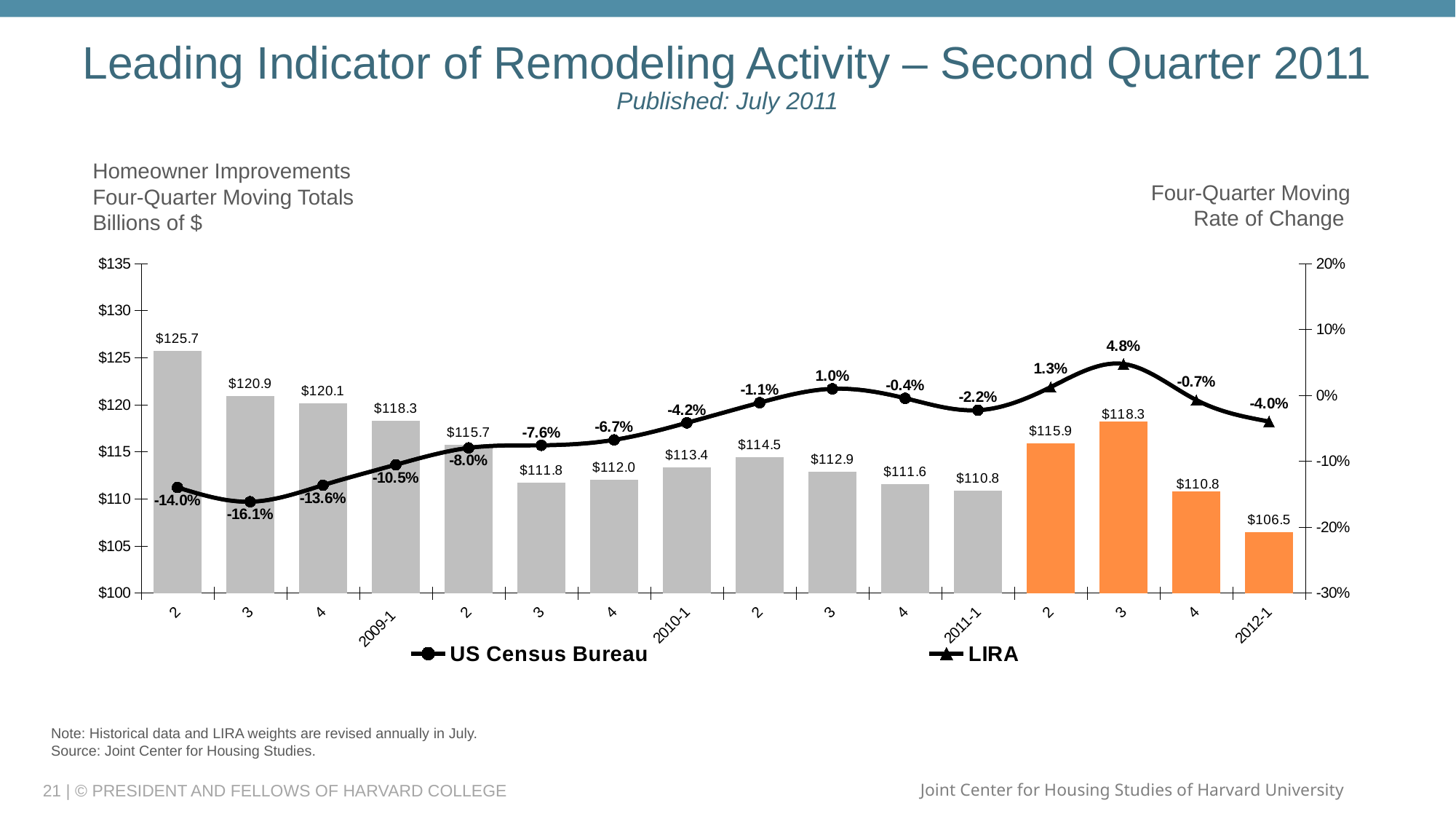
What is the lowest rate of change value plotted on the line? -16.1% What is the difference between the bar values for 2011-1 and 2012-1? $4.3 Which has the larger bar value, 2009-1 or 2010-1? 2009-1 Which category has the lowest bar value? 2012-1 What is the four-quarter moving rate of change shown for 2011-1? -2.2% What colour are the last four bars on the chart? Orange How many bars are plotted on the chart? 16 What is the highest bar value shown on the chart? $125.7 How many series does the legend list? 2 What is the value of the bar for 2012-1? $106.5 What is the value of the bar for 2010-1? $113.4 What is the highest rate of change value plotted on the line? 4.8%